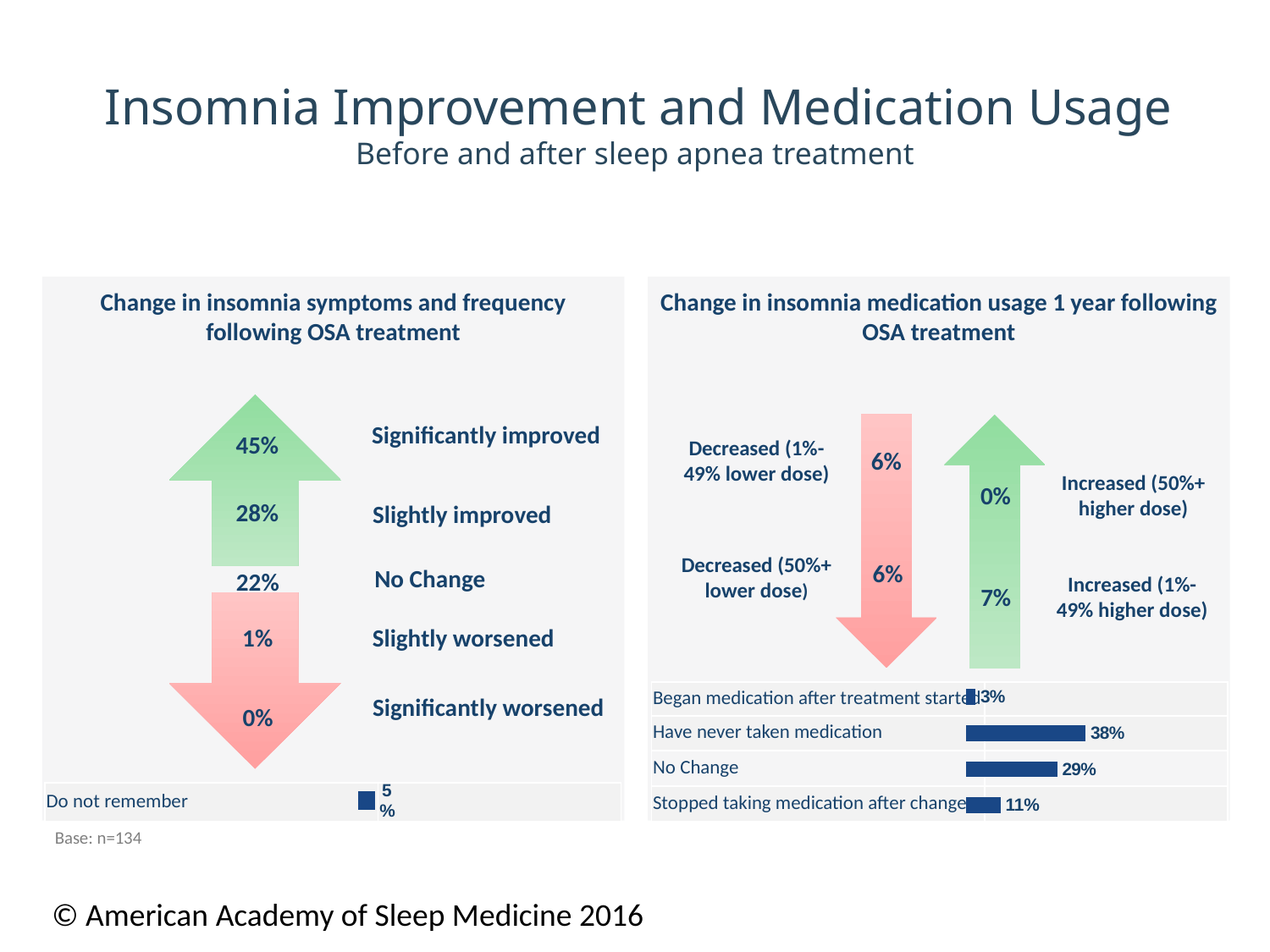
In the chart 'Change in insomnia symptoms and frequency following OSA treatment', what percentage reported 'No Change'? 22% In the chart 'Change in insomnia symptoms and frequency following OSA treatment', what percentage reported 'Significantly improved'? 45% In the chart 'Change in insomnia medication usage 1 year following OSA treatment', what percentage is shown for 'Increased (1%-49% higher dose)'? 7% In the chart 'Change in insomnia medication usage 1 year following OSA treatment', what is the difference between 'No Change' and 'Stopped taking medication after change'? 18% What is the base sample size noted below the charts? n=134 In the chart 'Change in insomnia symptoms and frequency following OSA treatment', what percentage reported 'Slightly improved'? 28% In the chart 'Change in insomnia symptoms and frequency following OSA treatment', what percentage is shown for 'Do not remember'? 5% In the chart 'Change in insomnia medication usage 1 year following OSA treatment', what percentage is shown for 'Stopped taking medication after change'? 11% In the chart 'Change in insomnia symptoms and frequency following OSA treatment', what is the difference between 'Significantly improved' and 'Slightly improved'? 17% In the chart 'Change in insomnia medication usage 1 year following OSA treatment', what percentage is shown for 'Have never taken medication'? 38% In the chart 'Change in insomnia symptoms and frequency following OSA treatment', which category has the highest percentage? Significantly improved In the chart 'Change in insomnia medication usage 1 year following OSA treatment', which is larger: 'Have never taken medication' or 'No Change'? Have never taken medication